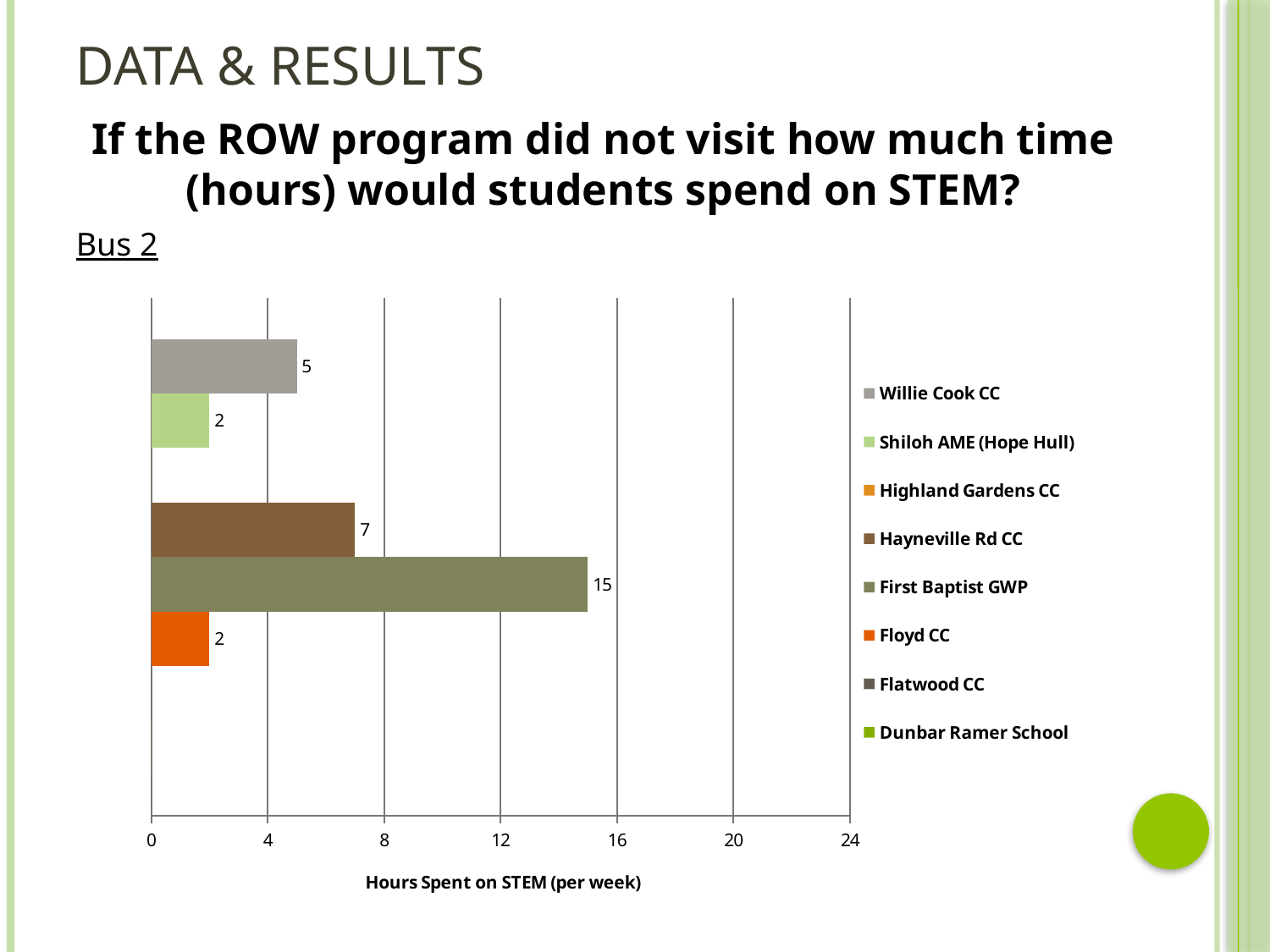
What is the value for Floyd CC? 2 What is the value for Shiloh AME (Hope Hull)? 2 What kind of chart is shown on the slide? bar chart What is the value for Hayneville Rd CC? 7 What is the difference between the values for First Baptist GWP and Hayneville Rd CC? 8 What is the title of the horizontal axis? Hours Spent on STEM (per week) Is the value for First Baptist GWP greater or less than 12? greater How many series does the legend list? 8 What is the value for Willie Cook CC? 5 Which site has the highest number of hours spent on STEM? First Baptist GWP Which is larger, the value for Willie Cook CC or the value for Hayneville Rd CC? Hayneville Rd CC How many hours per week would students at First Baptist GWP spend on STEM? 15